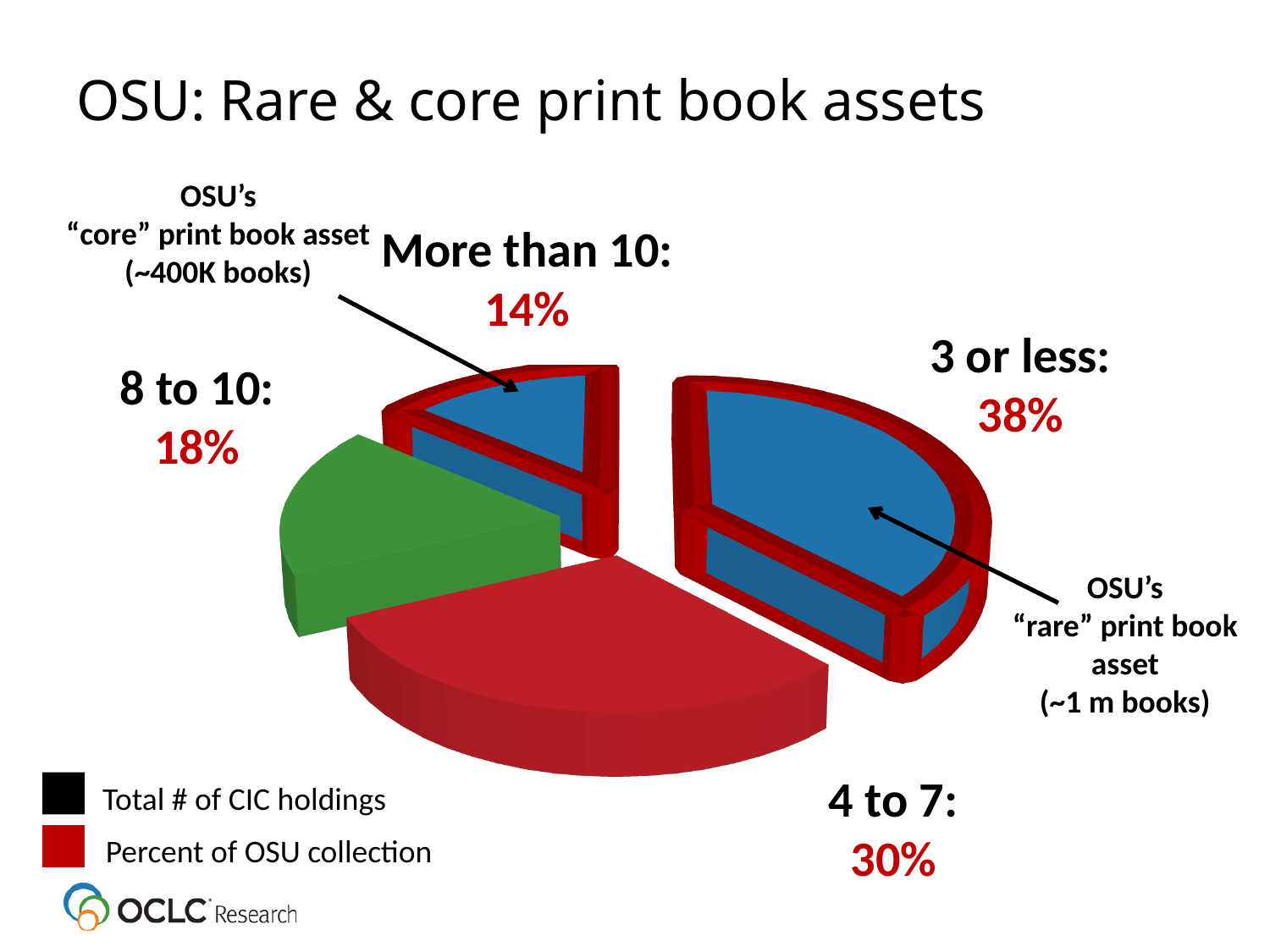
According to the legend, what does the red colour represent? Percent of OSU collection How many slices does the pie chart have? 4 Which is larger, the share for "8 to 10" or the share for "More than 10"? 8 to 10 Which category has the largest share of the pie? 3 or less What percentage is shown for the "8 to 10" category? 18% Which slice is labelled as OSU's "rare" print book asset (~1 m books)? 3 or less What is the difference in percentage points between the "3 or less" and "4 to 7" categories? 8 Which category has the smallest share of the pie? More than 10 What percentage of the OSU collection falls in the "3 or less" category? 38% What percentage is shown for the "More than 10" category? 14% What kind of chart is shown on the slide? Pie chart What percentage is shown for the "4 to 7" category? 30%